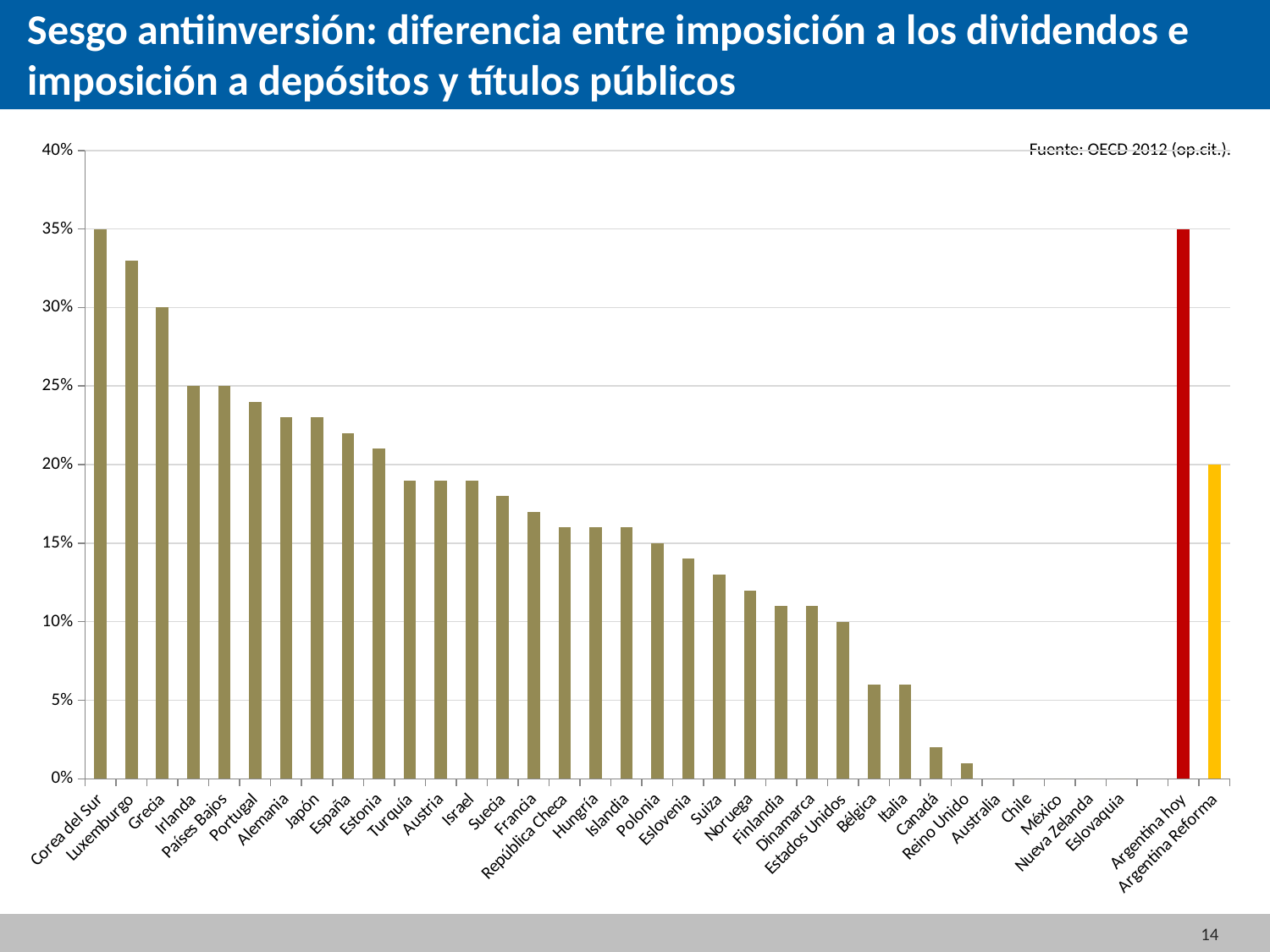
Is the value for Canadá greater or less than 5%? less Is the value for Luxemburgo greater or less than 30%? greater What is the value for Corea del Sur? 35% What kind of chart is shown on the slide? bar chart Which is larger, the value for Argentina hoy or the value for Argentina Reforma? Argentina hoy What is the value for Argentina Reforma? 20% What is the value for Estados Unidos? 10% Do the values for the OECD countries rise or fall from left to right along the x axis? fall What is the value for Grecia? 30% What colour is the bar for Argentina hoy? red Is the value for Suecia greater or less than 20%? less What is the difference between the values for Argentina hoy and Argentina Reforma? 15%